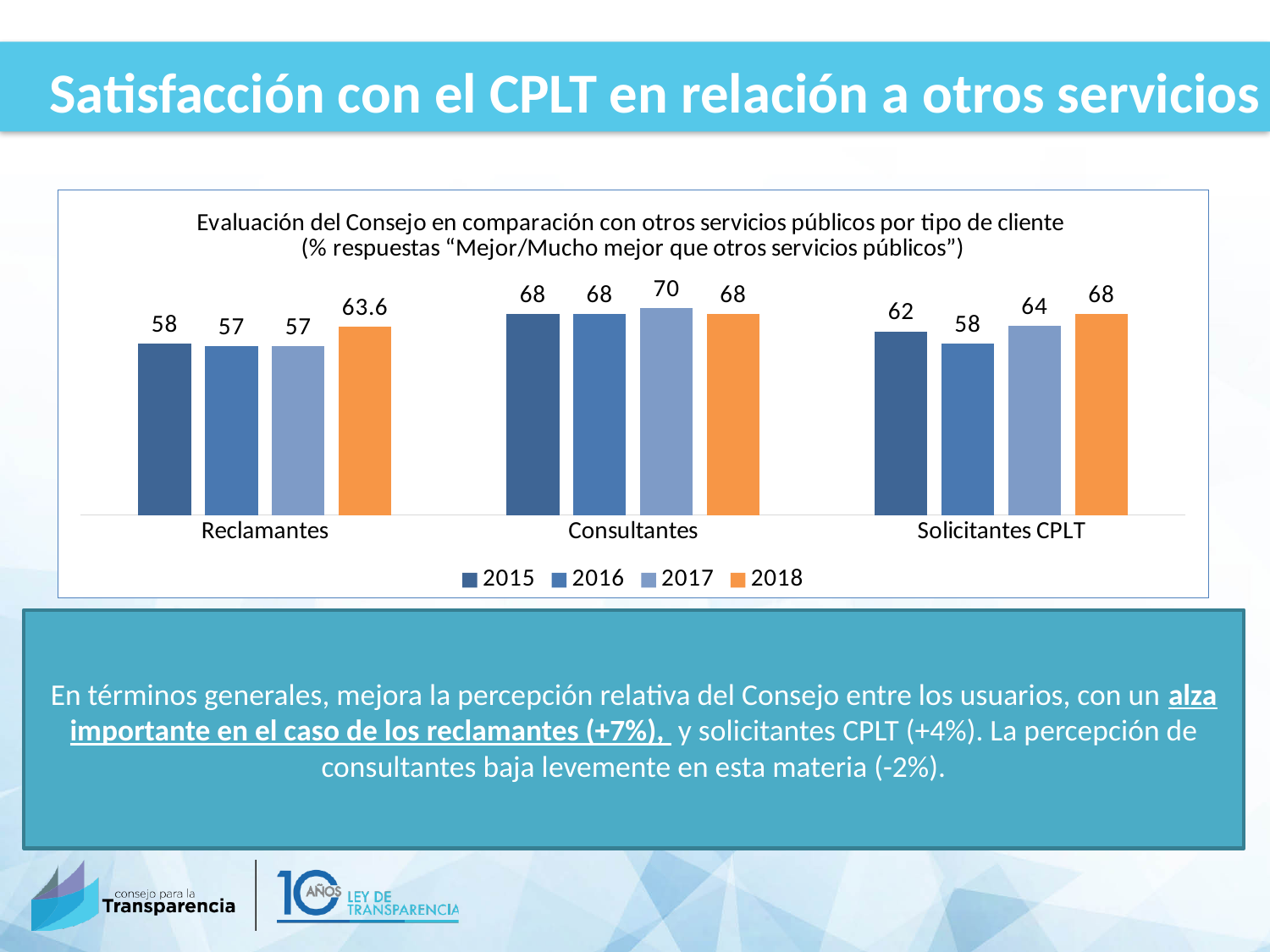
Which category has the lowest value in 2016? Reclamantes How many series does the legend list? 4 Which series is shown in orange in the legend? 2018 What is the value for Reclamantes in 2018? 63.6 Which is larger for Reclamantes: the 2015 value or the 2018 value? 2018 What is the value for Consultantes in 2017? 70 How many categories are shown on the x axis? 3 Which category has the highest value in 2017? Consultantes What kind of chart is shown on the slide? Bar chart What is the value for Solicitantes CPLT in 2016? 58 What is the difference between the 2018 and 2015 values for Solicitantes CPLT? 6 Do the values for Solicitantes CPLT rise or fall from 2016 to 2018? Rise